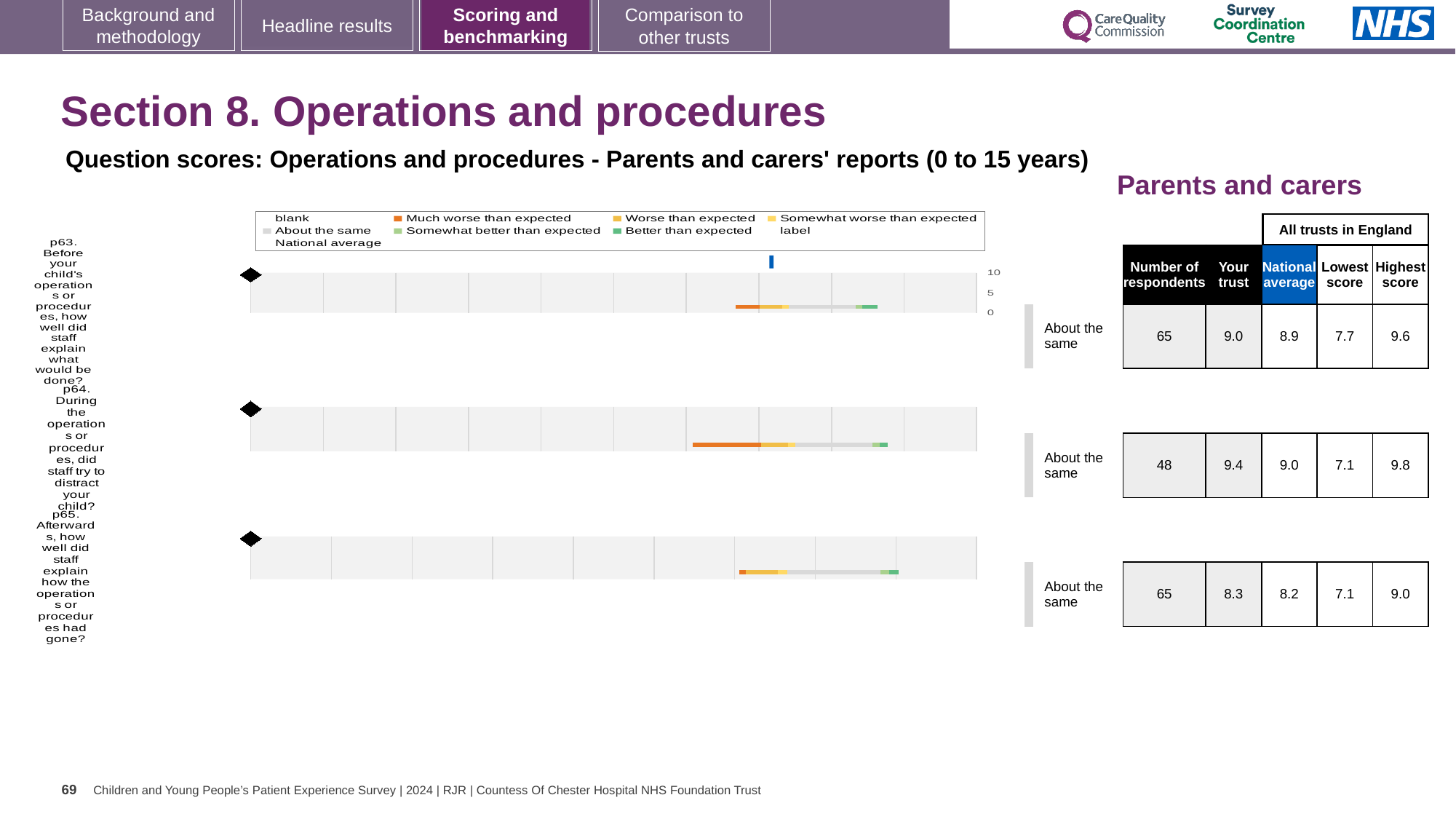
For p63, which is larger: the 'Your trust' score or the national average? Your trust What is the national average score for p64 (During the operations or procedures, did staff try to distract your child?)? 9.0 What benchmark category is shown for p65 (Afterwards, how well did staff explain how the operations or procedures had gone?)? About the same How many questions (charts) are shown on this slide? 3 What is the 'Your trust' score for p63 (Before your child's operations or procedures, how well did staff explain what would be done?)? 9.0 What is the lowest score across all trusts in England for p63? 7.7 Which question has the lowest 'Your trust' score on this slide? p65 What is the highest score across all trusts in England for p65 (Afterwards, how well did staff explain how the operations or procedures had gone?)? 9.0 What is the difference between the 'Your trust' score and the national average for p64? 0.4 How many respondents answered p64 (During the operations or procedures, did staff try to distract your child?)? 48 Which question has the highest 'Your trust' score on this slide? p64 What kind of chart is used to show each question's score? Bar chart